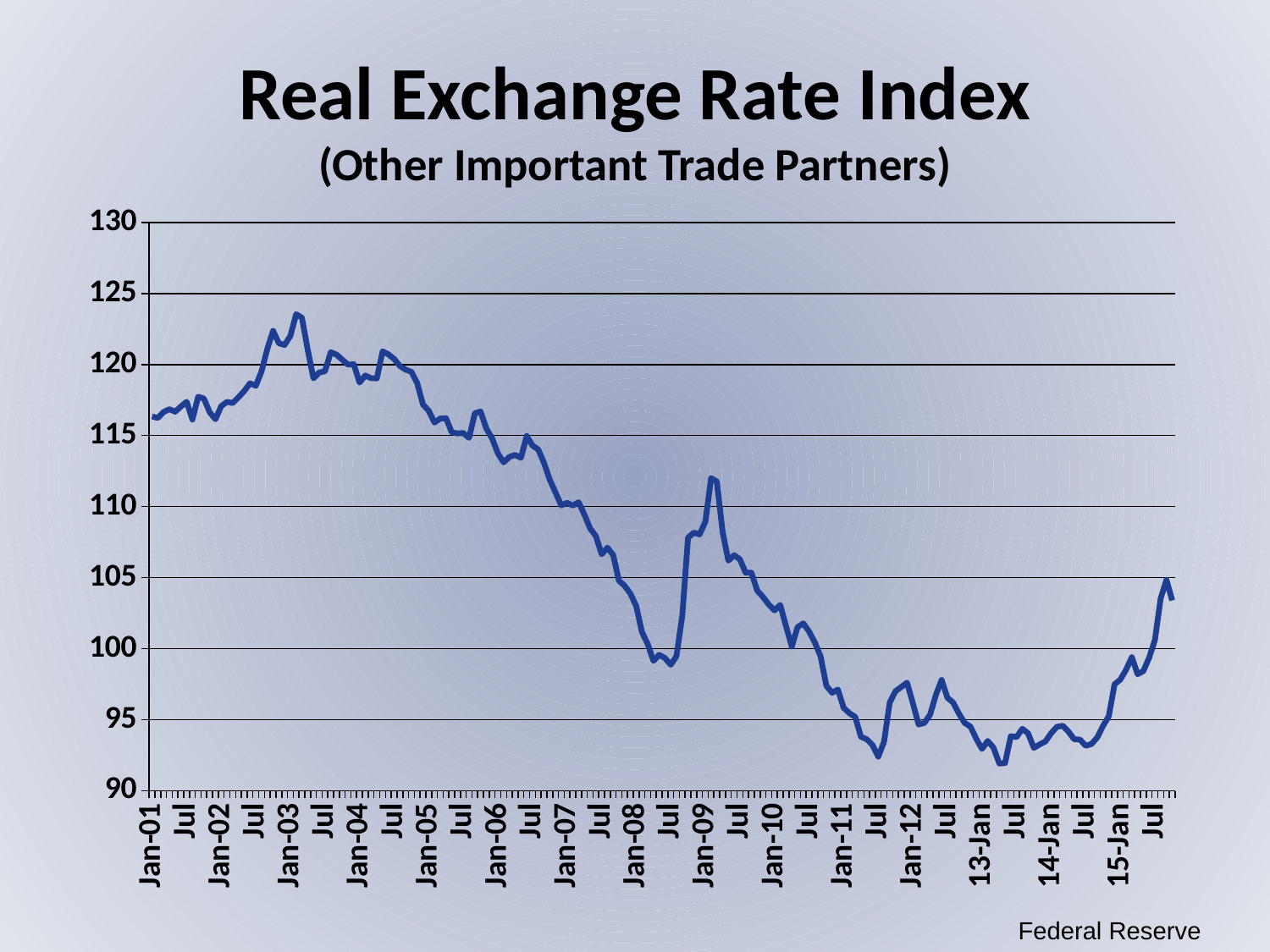
Is the value for Jan-03 greater or less than 120? greater Is the value for 13-Jan greater or less than 95? less Is the value for Jan-08 greater or less than 105? less What kind of chart is shown on the slide? line chart Does the index generally rise or fall between Jan-01 and 13-Jan? fall In which year does the line reach its highest point? 2003 Does the index rise or fall between 14-Jan and the end of the series? rise What source is cited at the bottom right of the slide? Federal Reserve What is the title of the chart? Real Exchange Rate Index (Other Important Trade Partners)